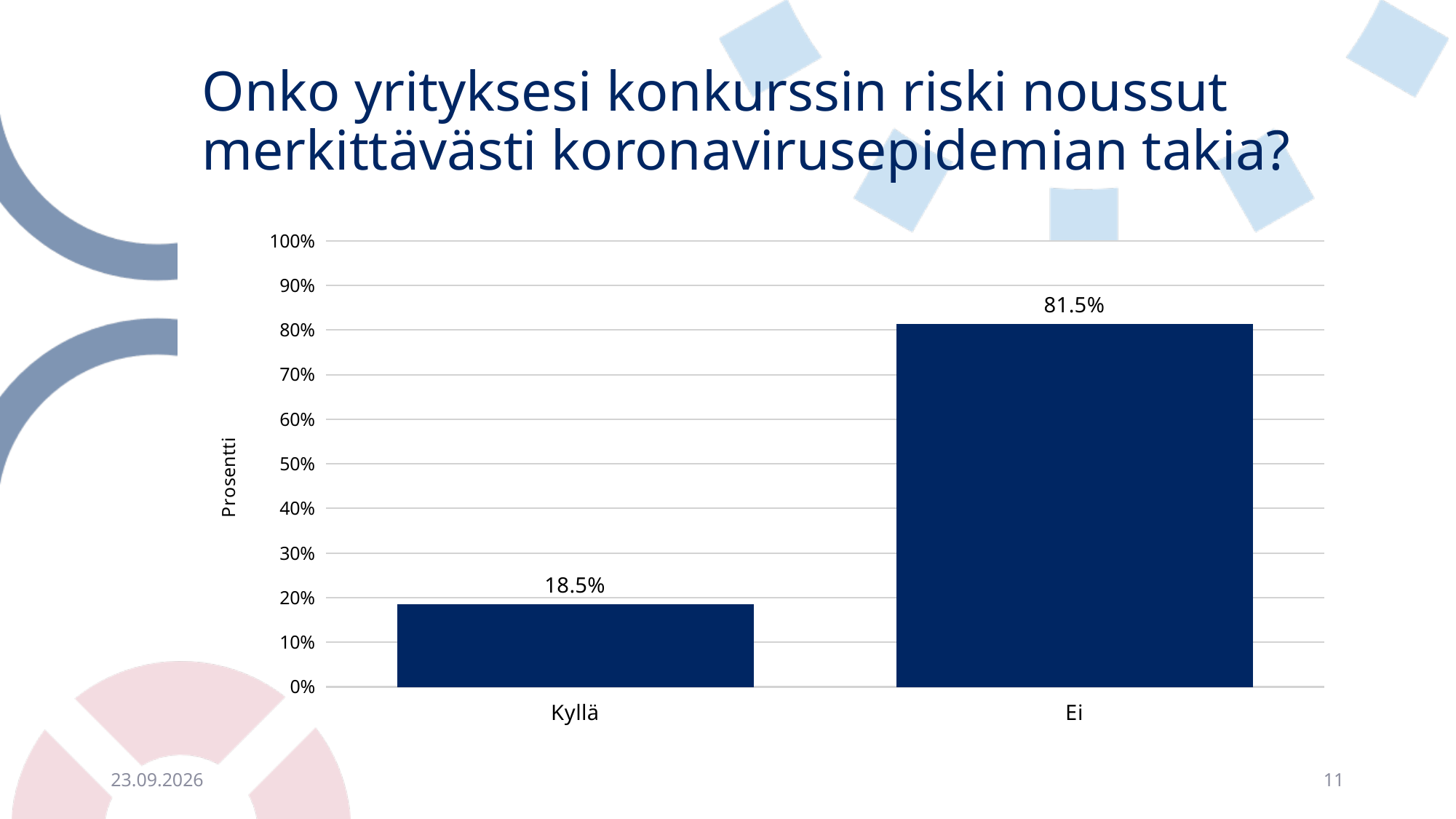
What is the value for Ei? 81.5% How many categories are shown on the x axis? 2 Is the value for Ei greater or less than 80%? greater Is the value for Kyllä greater or less than 20%? less Which category has the lowest value? Kyllä What is the label of the y axis? Prosentti What is the highest value shown on the y axis? 100% Which is larger, the value for Kyllä or the value for Ei? Ei What kind of chart is shown on the slide? bar chart What is the value for Kyllä? 18.5% Which category has the highest value? Ei What is the difference between the values for Ei and Kyllä? 63%